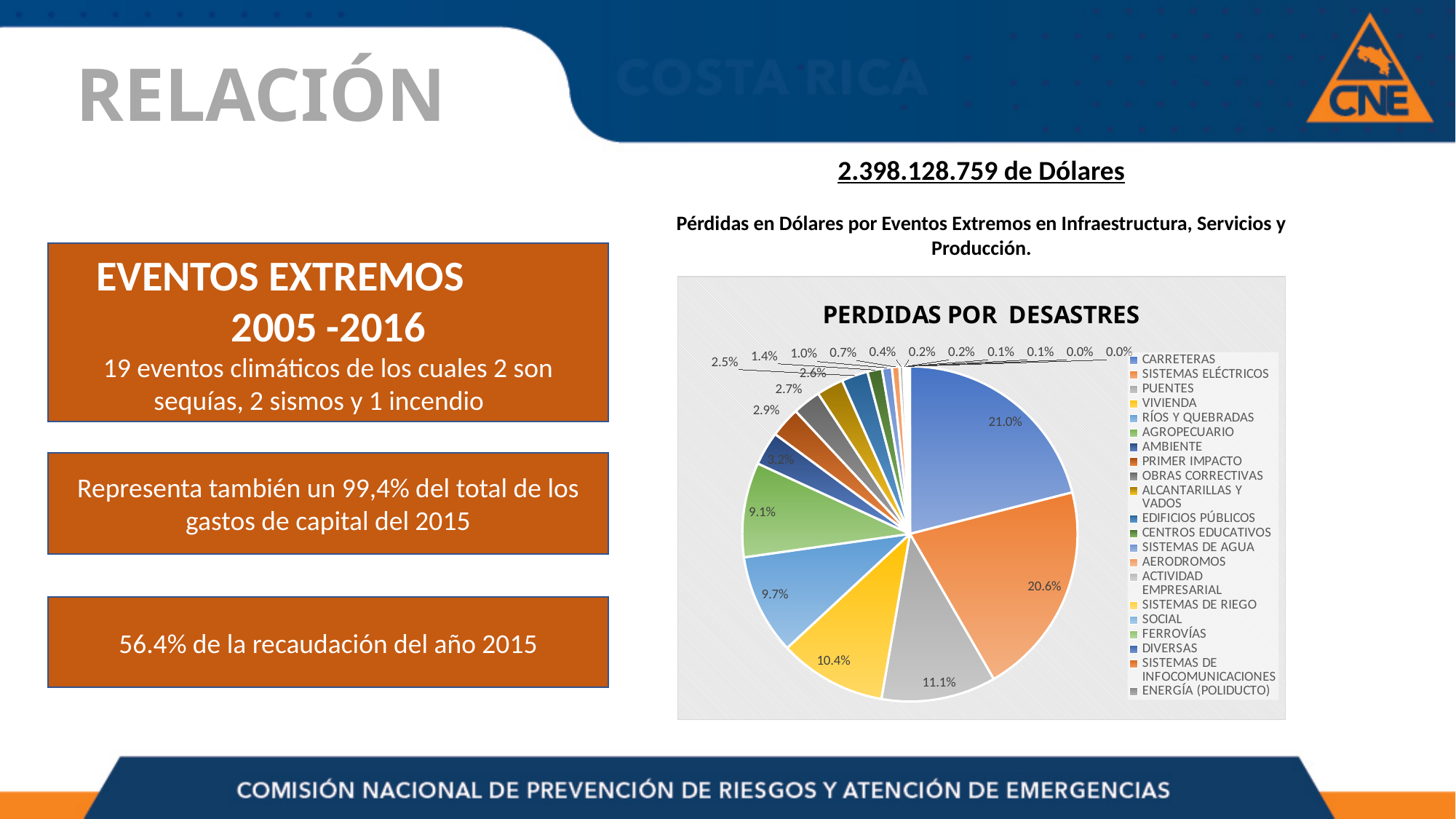
What share of the pie does PUENTES represent? 11.1% What share of the pie does VIVIENDA represent? 10.4% How many categories does the legend of the pie chart list? 21 What colour is the slice for SISTEMAS ELÉCTRICOS? Orange What share of the pie does SISTEMAS ELÉCTRICOS represent? 20.6% What share of the pie does CARRETERAS represent? 21.0% What kind of chart is shown under the title PERDIDAS POR DESASTRES? Pie chart What share of the pie does AGROPECUARIO represent? 9.1% Which is larger, the slice for RÍOS Y QUEBRADAS or the slice for VIVIENDA? VIVIENDA What is the difference in percentage points between the CARRETERAS slice and the SISTEMAS ELÉCTRICOS slice? 0.4 percentage points What is the title of the pie chart? PERDIDAS POR DESASTRES Which category has the largest slice of the pie? CARRETERAS